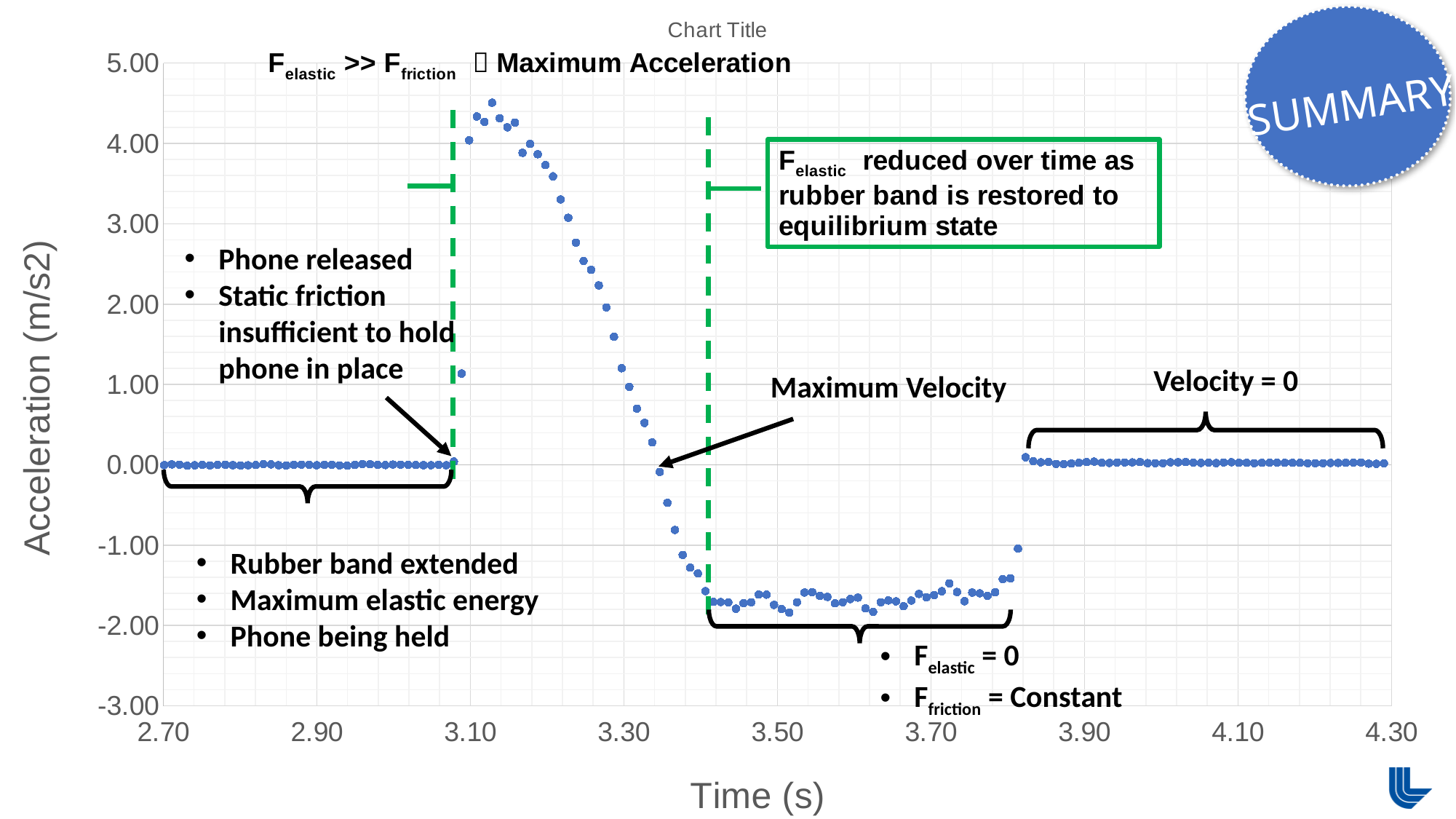
Is the acceleration at time 4.10 greater or less than 1.00? less Is the acceleration at time 3.30 greater or less than 3.00? less What kind of chart is shown on the slide? scatter chart Is the acceleration at time 3.20 greater or less than 3.00? greater What is the title of the x axis? Time (s) What is the lowest value shown on the y axis? -3.00 Is the acceleration at time 3.15 larger or smaller than the acceleration at time 3.60? larger What is the title of the y axis? Acceleration (m/s2) Do the acceleration values rise or fall as time goes from 3.10 to 3.40? fall